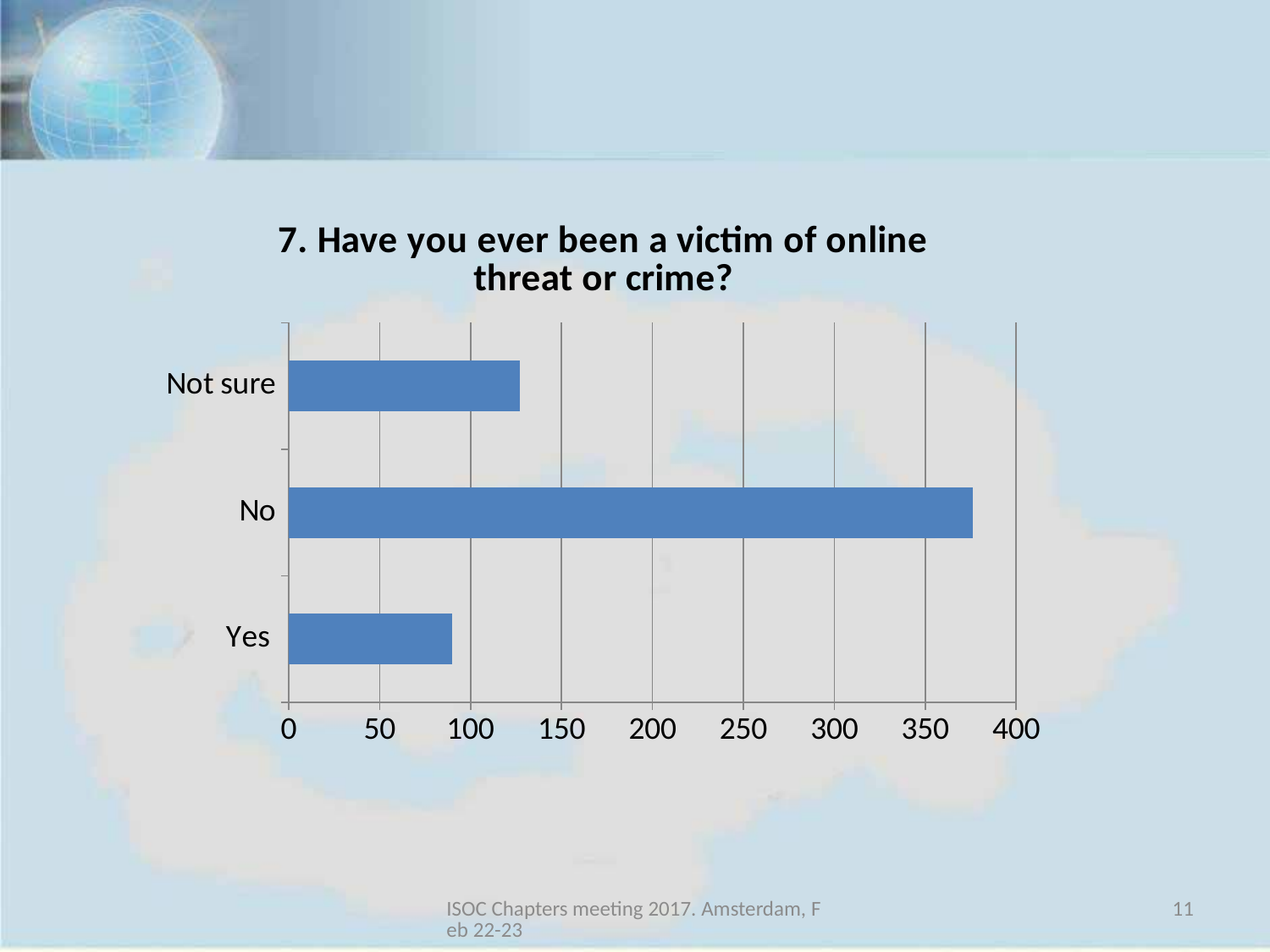
How many categories are plotted in the chart? 3 Is the value for No greater or less than 350? greater Is the value for Yes greater or less than 100? less What is the title of the chart? 7. Have you ever been a victim of online threat or crime? What kind of chart is shown on the slide? bar chart What is the highest value shown on the horizontal axis? 400 Is the value for Not sure greater or less than 150? less Which is larger, the value for Not sure or the value for Yes? Not sure Which category has the highest value? No Which category has the lowest value? Yes Which is larger, the value for No or the value for Not sure? No